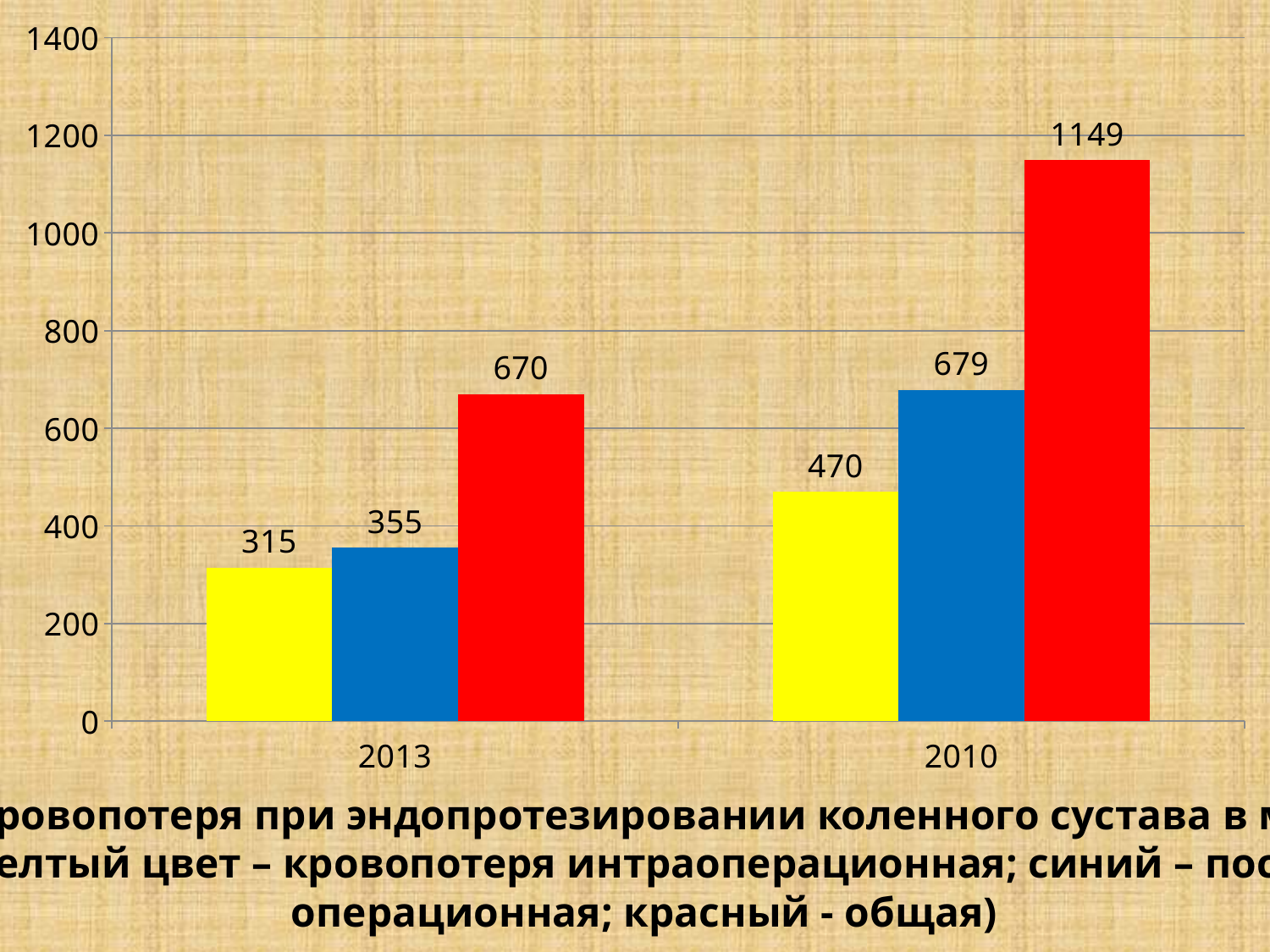
How many categories are shown on the x axis? 2 What is the value of the red bar for 2013? 670 What is the value of the yellow bar for 2010? 470 What is the value of the blue bar for 2013? 355 What is the difference between the red bar values for 2010 and 2013? 479 Which bar has the highest value on the chart? the red bar for 2010 (1149) What is the value of the red bar for 2010? 1149 What type of chart is shown on the slide? bar chart Which is larger, the blue bar for 2010 or the blue bar for 2013? the blue bar for 2010 What is the value of the blue bar for 2010? 679 Which bar has the lowest value on the chart? the yellow bar for 2013 (315) What is the value of the yellow bar for 2013? 315